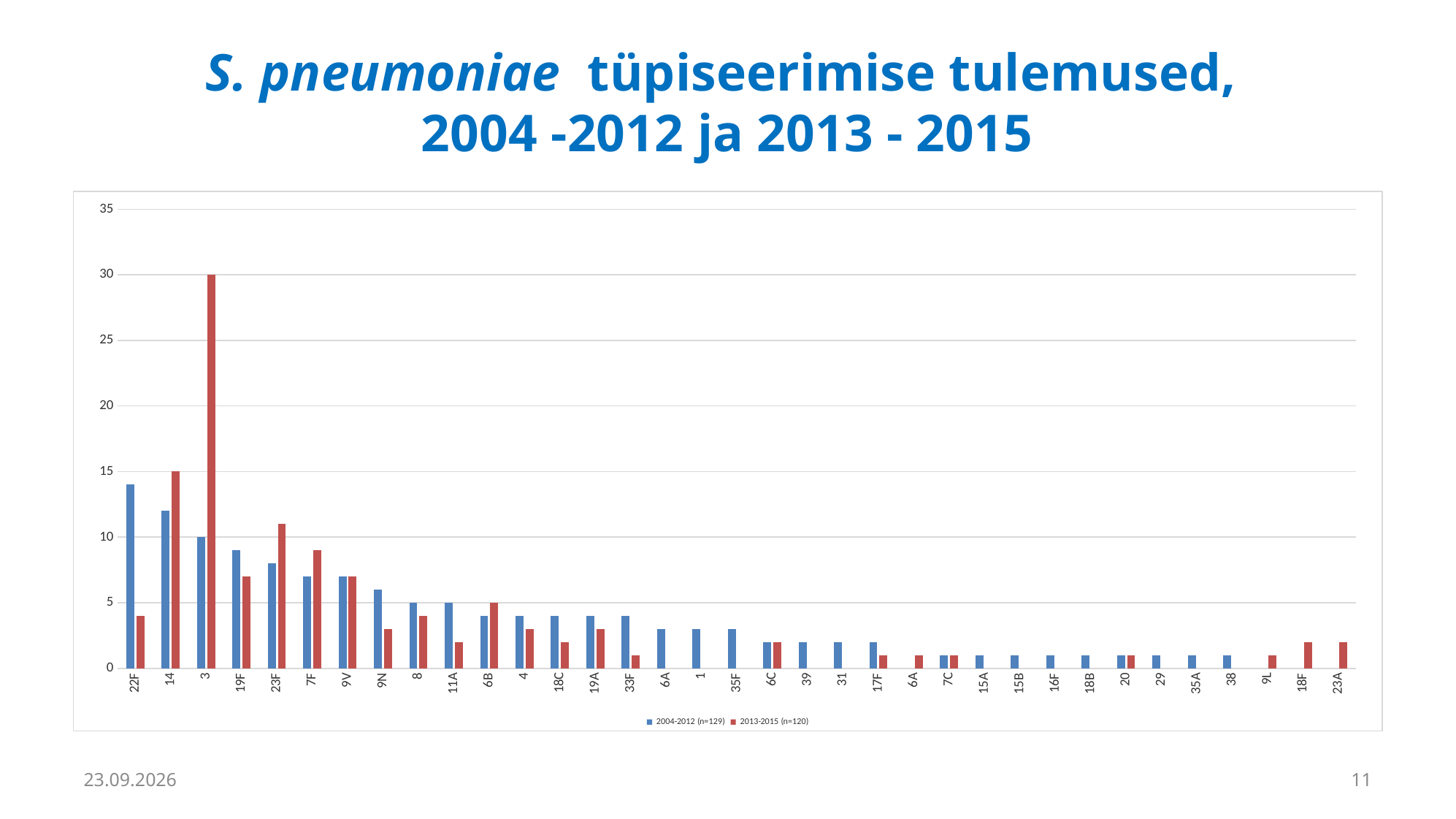
Which serotype has the highest value in the 2013-2015 (n=120) series? 3 Do the values of the 2004-2012 (n=129) series generally rise or fall from left to right along the x axis? fall For serotype 14, which series has the larger value: 2004-2012 (n=129) or 2013-2015 (n=120)? 2013-2015 (n=120) What is the value for serotype 14 in the 2013-2015 (n=120) series? 15 For serotype 22F, which series has the larger value: 2004-2012 (n=129) or 2013-2015 (n=120)? 2004-2012 (n=129) What is the value for serotype 3 in the 2004-2012 (n=129) series? 10 Which serotype has the highest value in the 2004-2012 (n=129) series? 22F Is the value for serotype 22F in the 2004-2012 (n=129) series greater or less than 10? greater How many series does the legend list? 2 How many serotype categories are shown on the x axis? 35 What kind of chart is shown on the slide? bar chart What is the value for serotype 3 in the 2013-2015 (n=120) series? 30